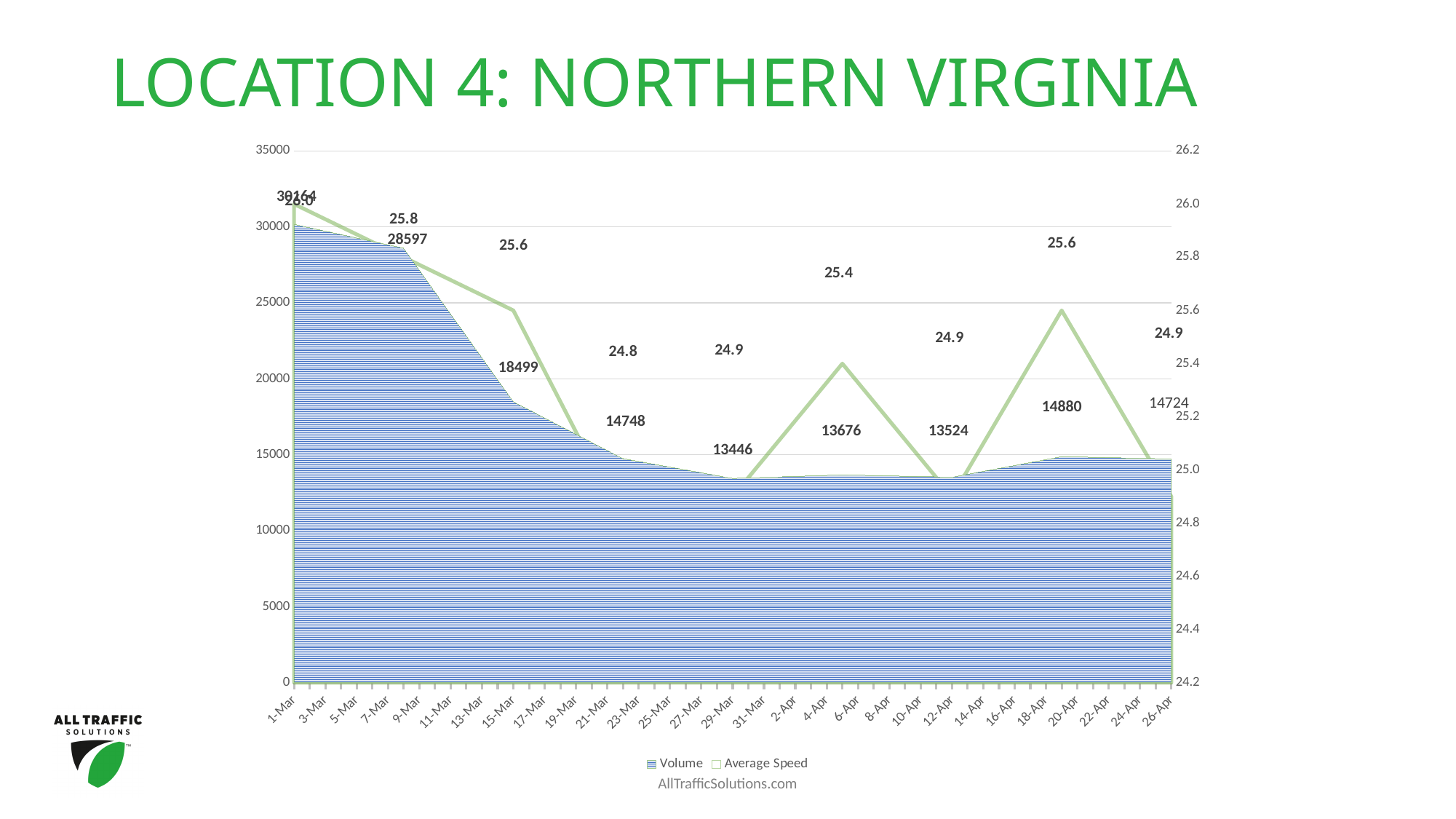
What are the two series named in the legend? Volume and Average Speed What is the difference between the Volume labelled at 15-Mar (18499) and at 29-Mar (13446)? 5053 Does the Volume rise or fall from 1-Mar to 29-Mar? Falls Which is larger, the Volume at 12-Apr or the Volume at 26-Apr? 26-Apr What is the Volume value labelled at 12-Apr? 13524 What is the Volume value labelled at 29-Mar? 13446 How many series does the legend list? 2 What is the lowest Average Speed value labelled on the chart? 24.8 What is the Average Speed value labelled at 26-Apr? 24.9 What is the Volume value labelled at 26-Apr? 14724 What is the Volume value labelled at 15-Mar? 18499 What kind of chart is shown on the slide? A combined area and line chart